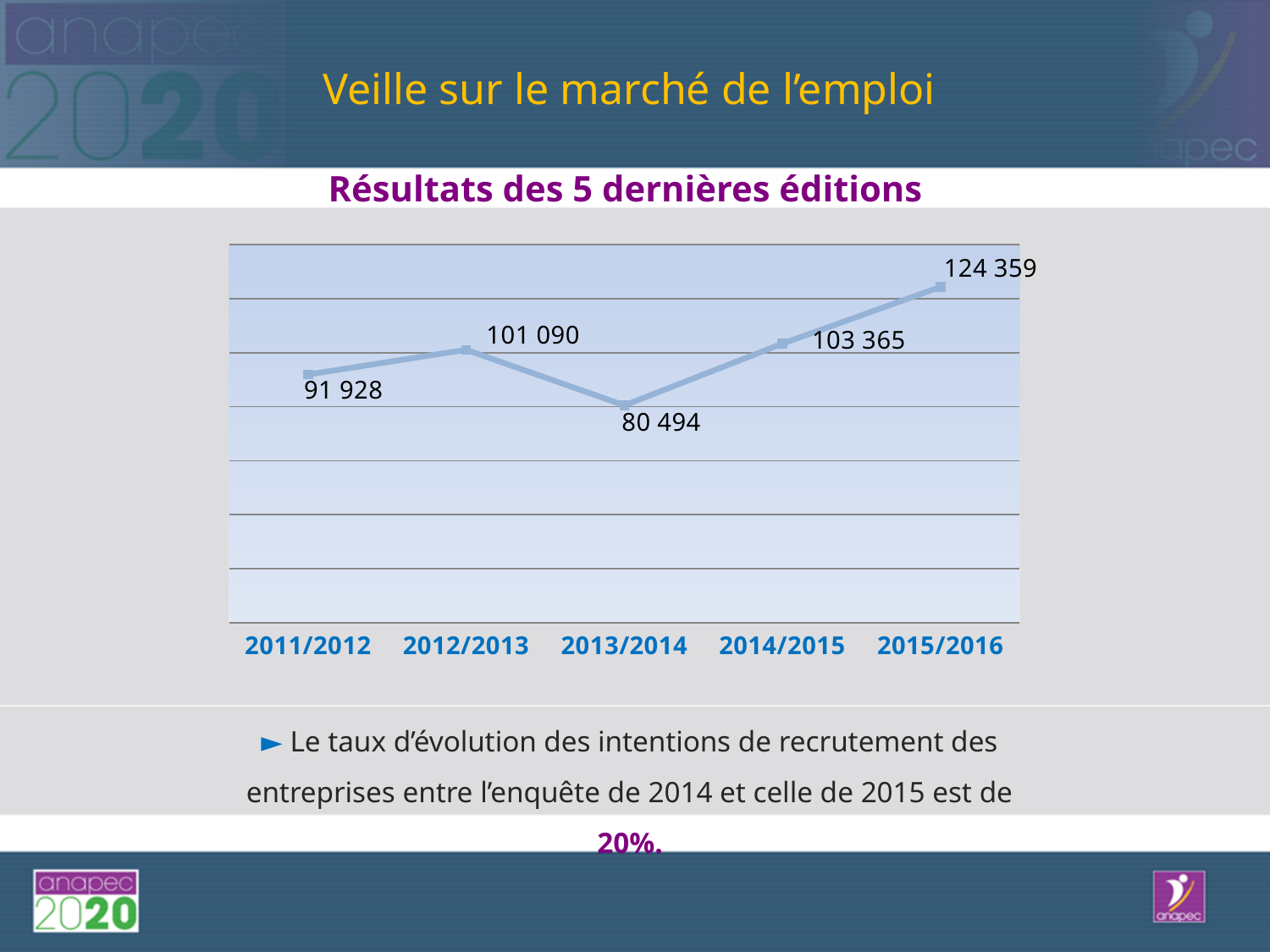
What is the value for 2015/2016? 124 359 Which is larger, the value for 2012/2013 or the value for 2014/2015? 2014/2015 What is the value for 2014/2015? 103 365 What kind of chart is shown on the slide? Line chart Which edition has the highest value? 2015/2016 What is the difference between the values for 2015/2016 and 2014/2015? 20 994 Does the value rise or fall from 2013/2014 to 2015/2016? Rise What is the value for 2013/2014? 80 494 What is the value for 2011/2012? 91 928 Which edition has the lowest value? 2013/2014 How many editions are plotted on the chart? 5 What is the difference between the values for 2012/2013 and 2013/2014? 20 596